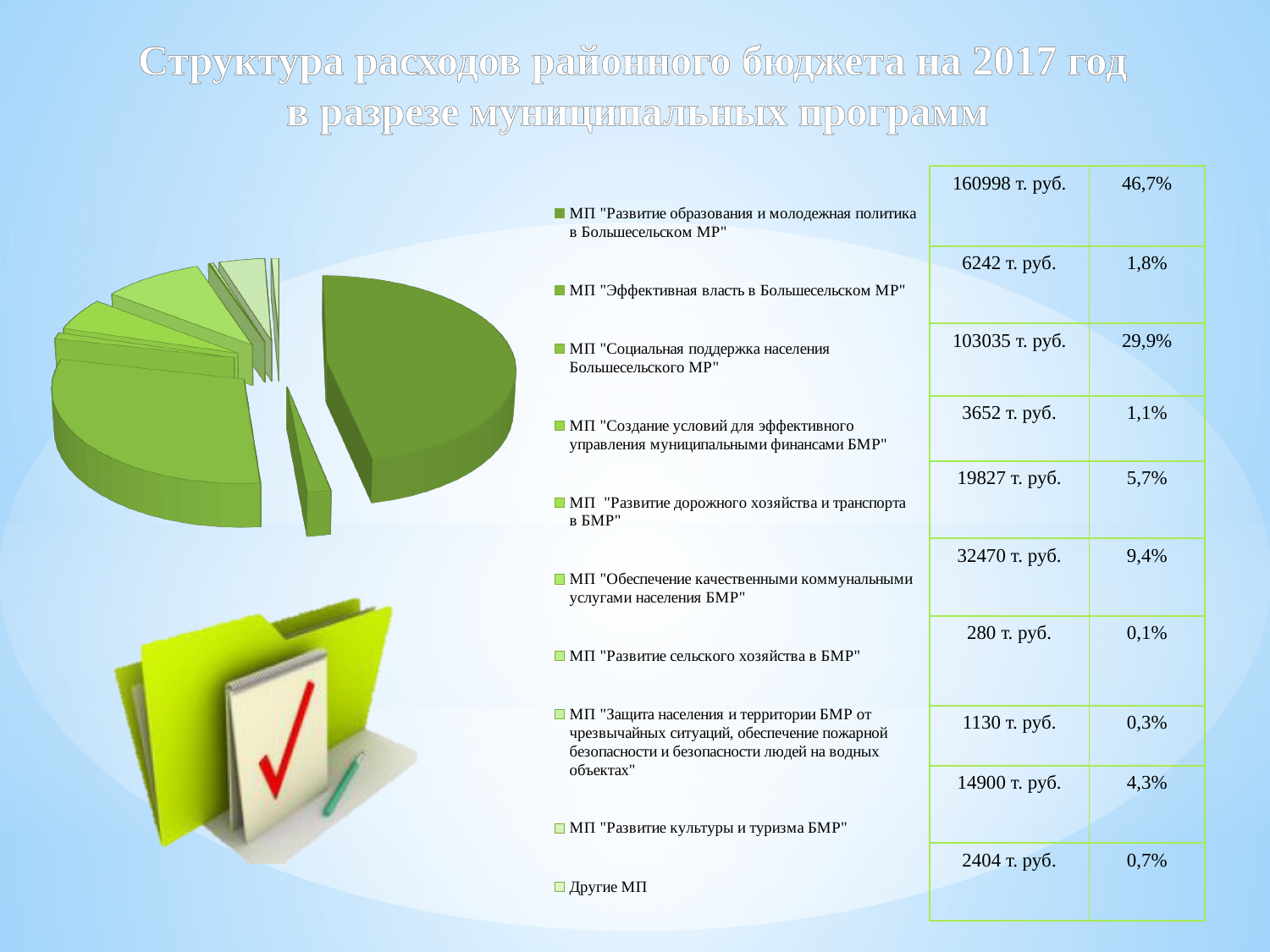
What share of the budget does МП "Развитие образования и молодежная политика в Большесельском МР" account for? 46,7% How many categories does the pie chart's legend list? 10 What is the expenditure amount for МП "Развитие культуры и туризма БМР"? 14900 т. руб. What is the expenditure amount for Другие МП? 2404 т. руб. What is the title of the slide containing the pie chart? Структура расходов районного бюджета на 2017 год в разрезе муниципальных программ What is the difference in percentage share between МП "Развитие образования и молодежная политика в Большесельском МР" and МП "Социальная поддержка населения Большесельского МР"? 16,8% What is the expenditure amount for МП "Социальная поддержка населения Большесельского МР"? 103035 т. руб. What kind of chart is shown on the slide? Pie chart What share of the budget does МП "Обеспечение качественными коммунальными услугами населения БМР" account for? 9,4% Which is larger: the expenditure for МП "Развитие дорожного хозяйства и транспорта в БМР" or for МП "Эффективная власть в Большесельском МР"? МП "Развитие дорожного хозяйства и транспорта в БМР" Which municipal programme has the largest share of the 2017 district budget expenditure? МП "Развитие образования и молодежная политика в Большесельском МР" Which municipal programme has the smallest share of the 2017 district budget expenditure? МП "Развитие сельского хозяйства в БМР"